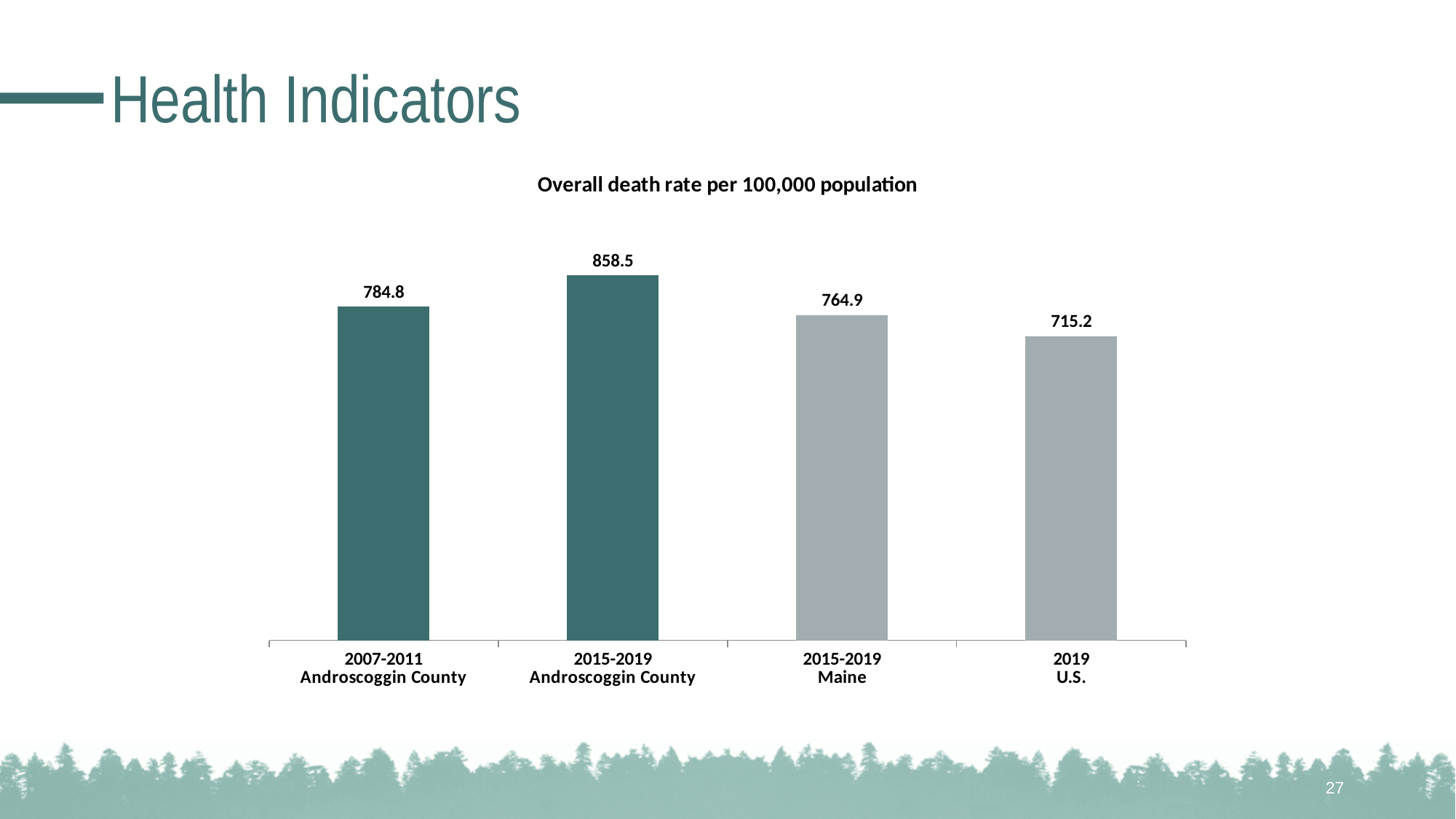
What type of chart is shown on the slide? Bar chart Which category has the lowest overall death rate? 2019 U.S. Which category has the highest overall death rate? 2015-2019 Androscoggin County What is the overall death rate per 100,000 population for Androscoggin County in 2007-2011? 784.8 What is the overall death rate per 100,000 population for the U.S. in 2019? 715.2 What is the overall death rate per 100,000 population for Maine in 2015-2019? 764.9 What is the title of the chart? Overall death rate per 100,000 population What is the difference between the 2015-2019 Androscoggin County death rate and the 2015-2019 Maine death rate? 93.6 How many bars are shown in the chart? 4 How much did the Androscoggin County death rate change from 2007-2011 to 2015-2019? 73.7 What is the overall death rate per 100,000 population for Androscoggin County in 2015-2019? 858.5 Which is larger, the 2015-2019 Maine death rate or the 2019 U.S. death rate? 2015-2019 Maine